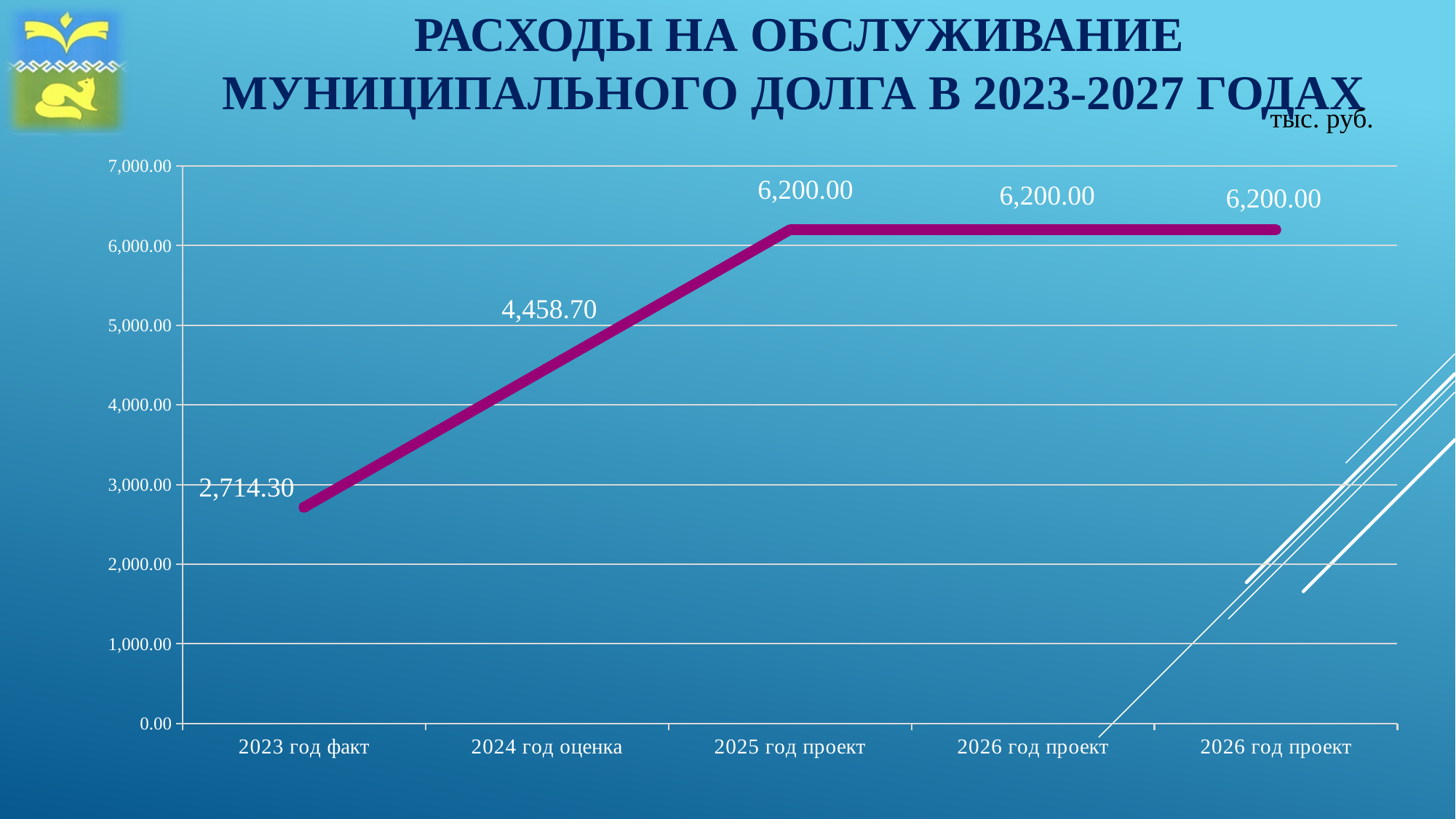
How many data points are plotted on the chart? 5 Which is larger, the value for 2023 год факт or the value for 2024 год оценка? 2024 год оценка What is the difference between the values for 2025 год проект and 2024 год оценка? 1,741.30 What is the value for 2023 год факт? 2,714.30 What is the difference between the values for 2024 год оценка and 2023 год факт? 1,744.40 What unit is indicated for the chart values? тыс. руб. Which category has the lowest value? 2023 год факт What type of chart is shown on the slide? line chart What is the value for 2024 год оценка? 4,458.70 Do the values rise or fall from 2023 год факт to 2025 год проект? rise What is the value of the last (rightmost) point on the chart? 6,200.00 What is the value for 2025 год проект? 6,200.00